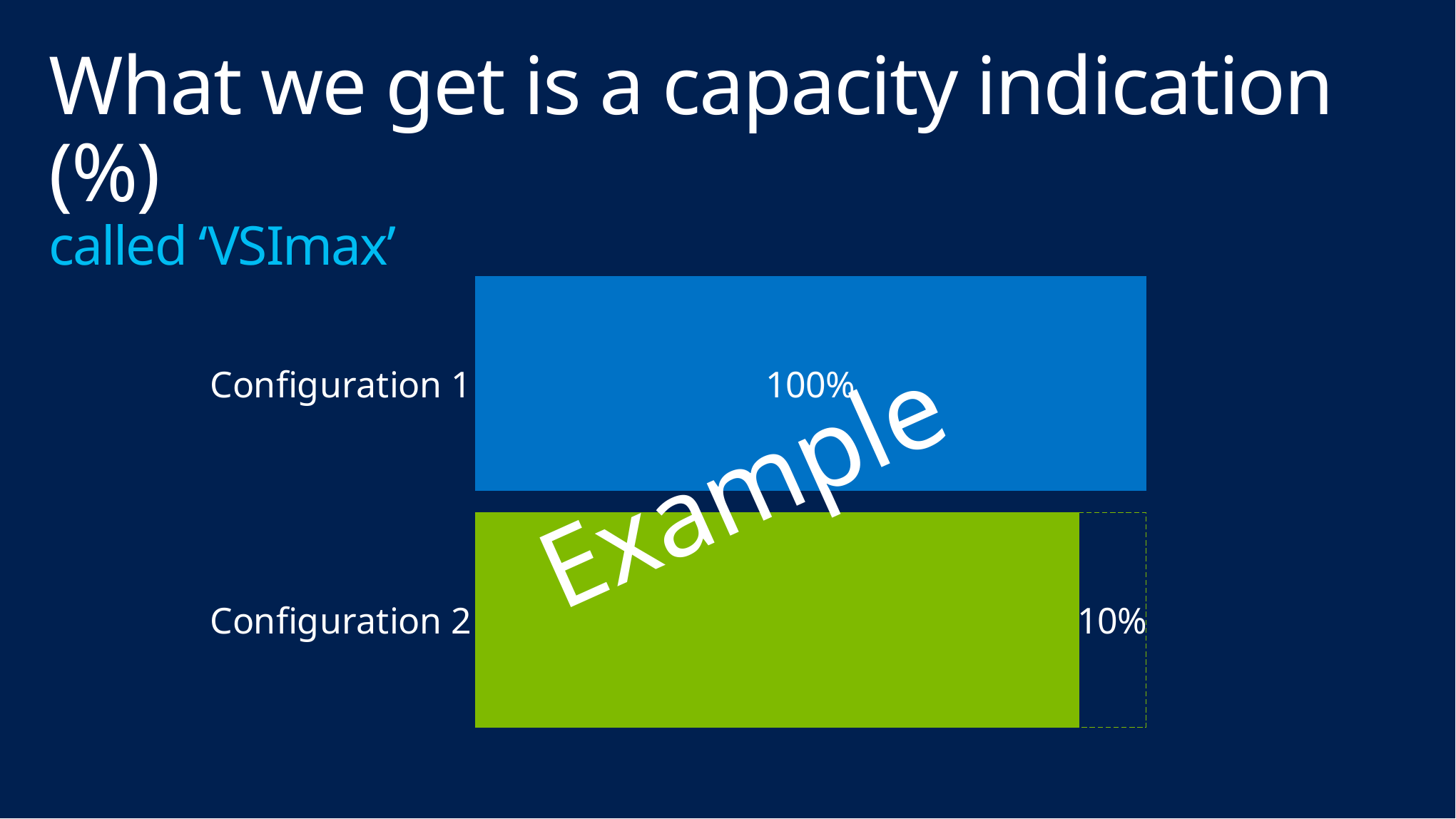
What word is written diagonally across the chart as a watermark? Example How many configurations are plotted in the chart? 2 What kind of chart is shown on the slide? bar chart Is the solid bar for Configuration 1 longer or shorter than the solid bar for Configuration 2? longer What value is labelled on the bar for Configuration 1? 100% Which configuration has the longer solid bar? Configuration 1 Which configuration has the shorter solid bar? Configuration 2 What value is labelled on the dashed segment at the end of the Configuration 2 bar? 10% What colour is the bar for Configuration 1? blue